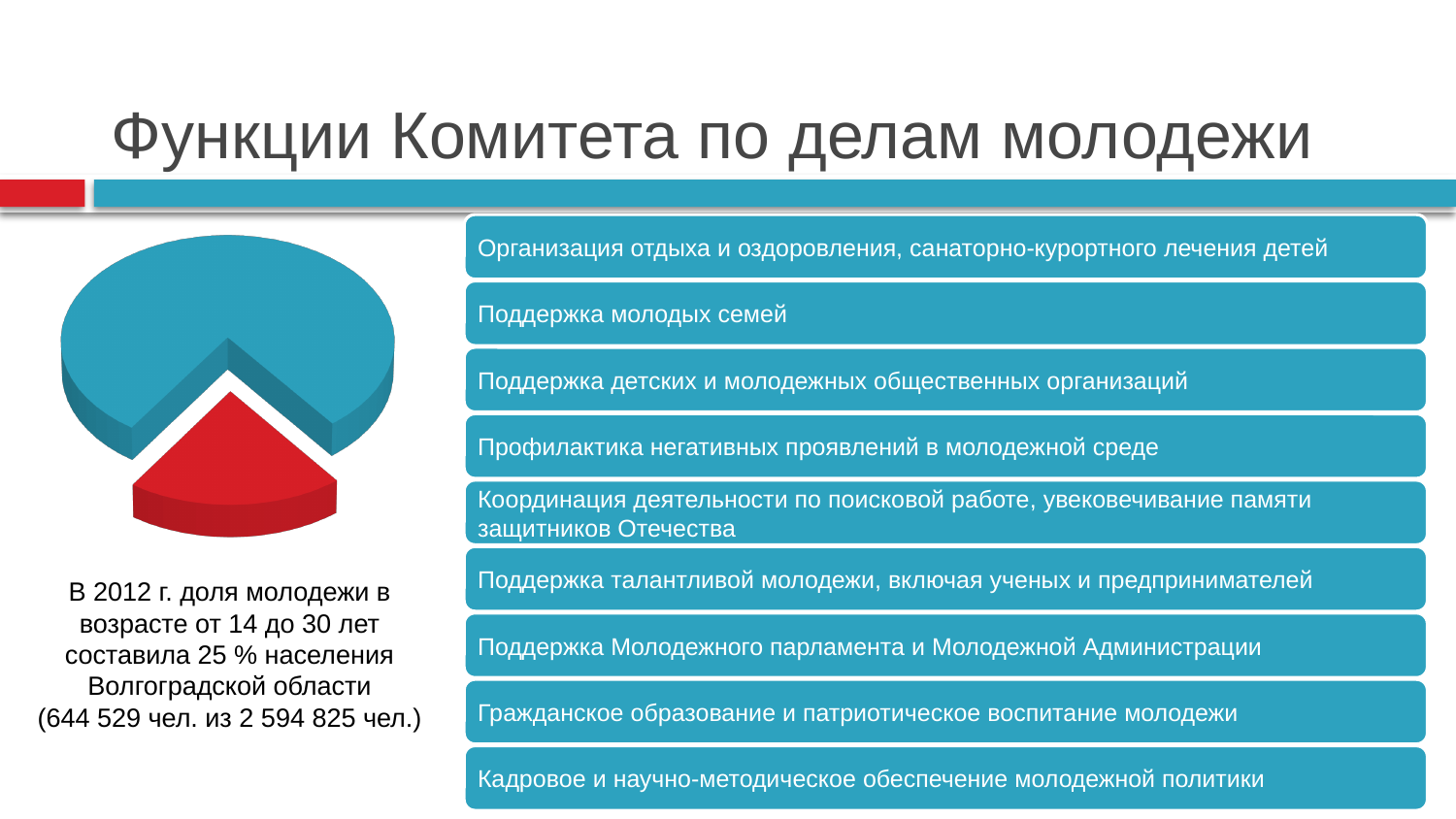
According to the caption under the pie chart, what was the total population of Volgograd region in 2012? 2 594 825 чел. According to the caption under the pie chart, how many young people aged 14 to 30 were there in Volgograd region in 2012? 644 529 чел. Which slice of the pie chart is pulled out (exploded) from the rest of the pie? the red slice According to the caption under the pie chart, what share of the population of Volgograd region did youth aged 14 to 30 make up in 2012? 25 % What two colours are used for the slices of the pie chart? blue and red What kind of chart is shown on the left of the slide? pie chart Which slice of the pie chart is the smallest? the red slice Which slice of the pie chart is the largest? the blue slice Which slice of the pie chart is larger, the blue one or the red one? the blue one Is the blue slice of the pie chart greater or less than 50% of the pie? greater Is the red slice of the pie chart greater or less than 50% of the pie? less How many slices does the pie chart have? 2